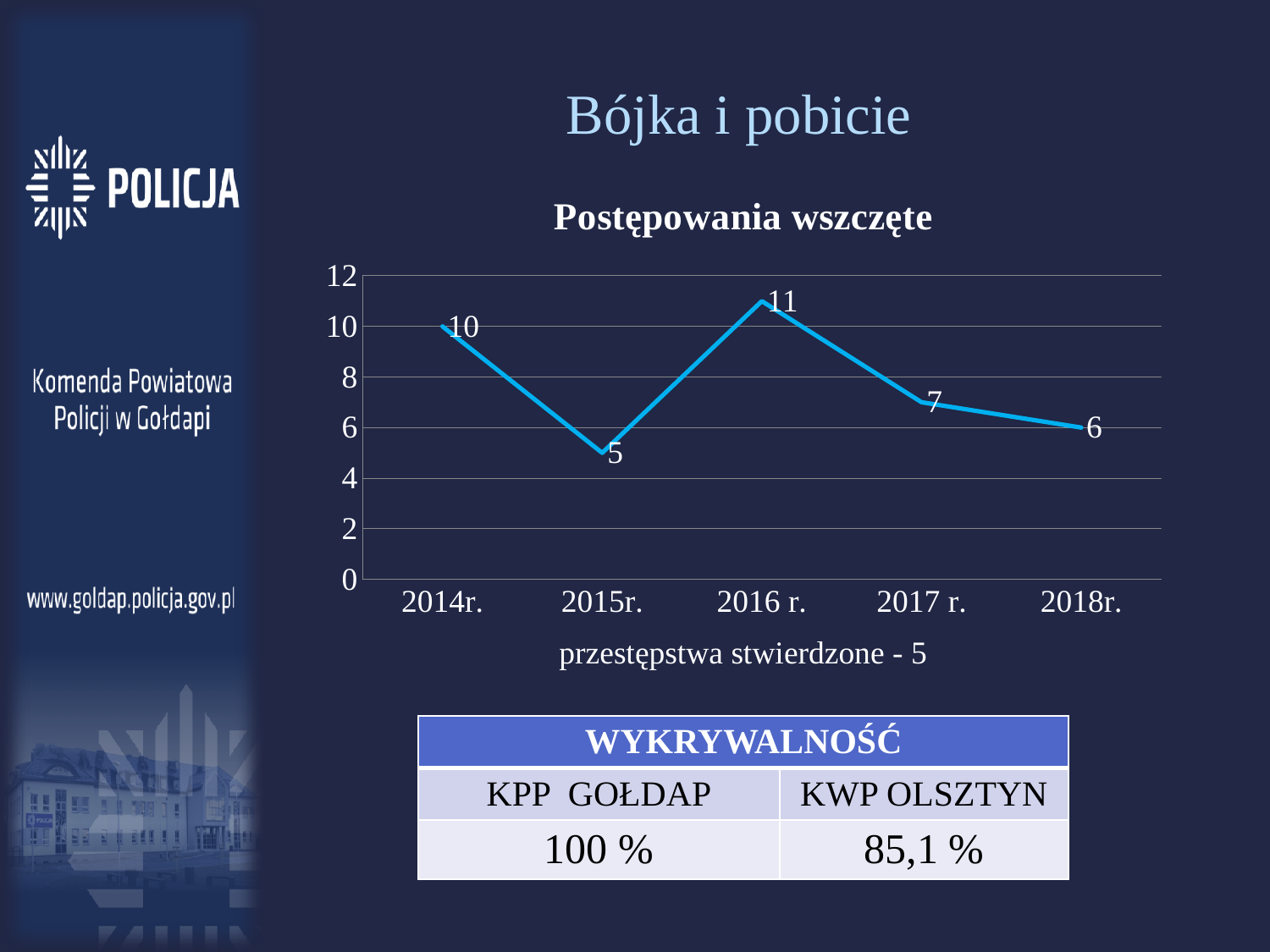
What is the value for 2018r. in the Postępowania wszczęte chart? 6 What is the value for 2014r. in the Postępowania wszczęte chart? 10 Which is larger in the Postępowania wszczęte chart, the value for 2014r. or the value for 2017 r.? 2014r. Which year has the lowest value in the Postępowania wszczęte chart? 2015r. What is the title of the chart on the slide? Postępowania wszczęte What is the difference between the values for 2016 r. and 2015r. in the Postępowania wszczęte chart? 6 How many years are shown on the x axis of the Postępowania wszczęte chart? 5 What kind of chart is the Postępowania wszczęte chart? line chart What is the value for 2015r. in the Postępowania wszczęte chart? 5 Do the values in the Postępowania wszczęte chart rise or fall from 2016 r. to 2018r.? fall Which year has the highest value in the Postępowania wszczęte chart? 2016 r. Is the value for 2017 r. in the Postępowania wszczęte chart greater or less than 8? less